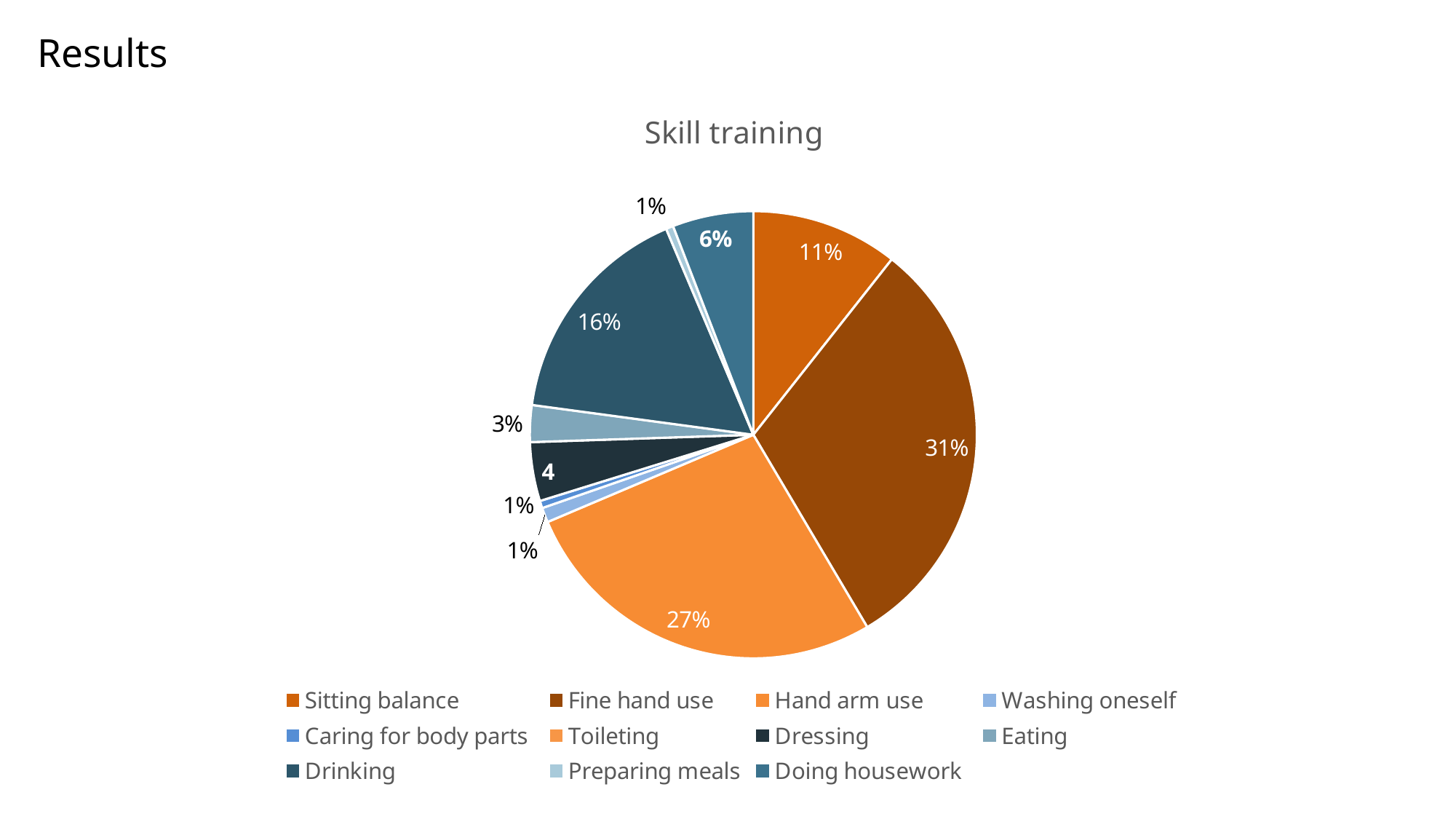
What is the title of the chart? Skill training How many categories does the legend list? 11 What share of the pie does Drinking have? 16% What kind of chart is shown on the slide? pie chart What share of the pie does Sitting balance have? 11% What share of the pie does Fine hand use have? 31% Which has a larger share, Hand arm use or Drinking? Hand arm use Which category has the largest share of the pie? Fine hand use What is the difference in percentage points between the Fine hand use share and the Hand arm use share? 4